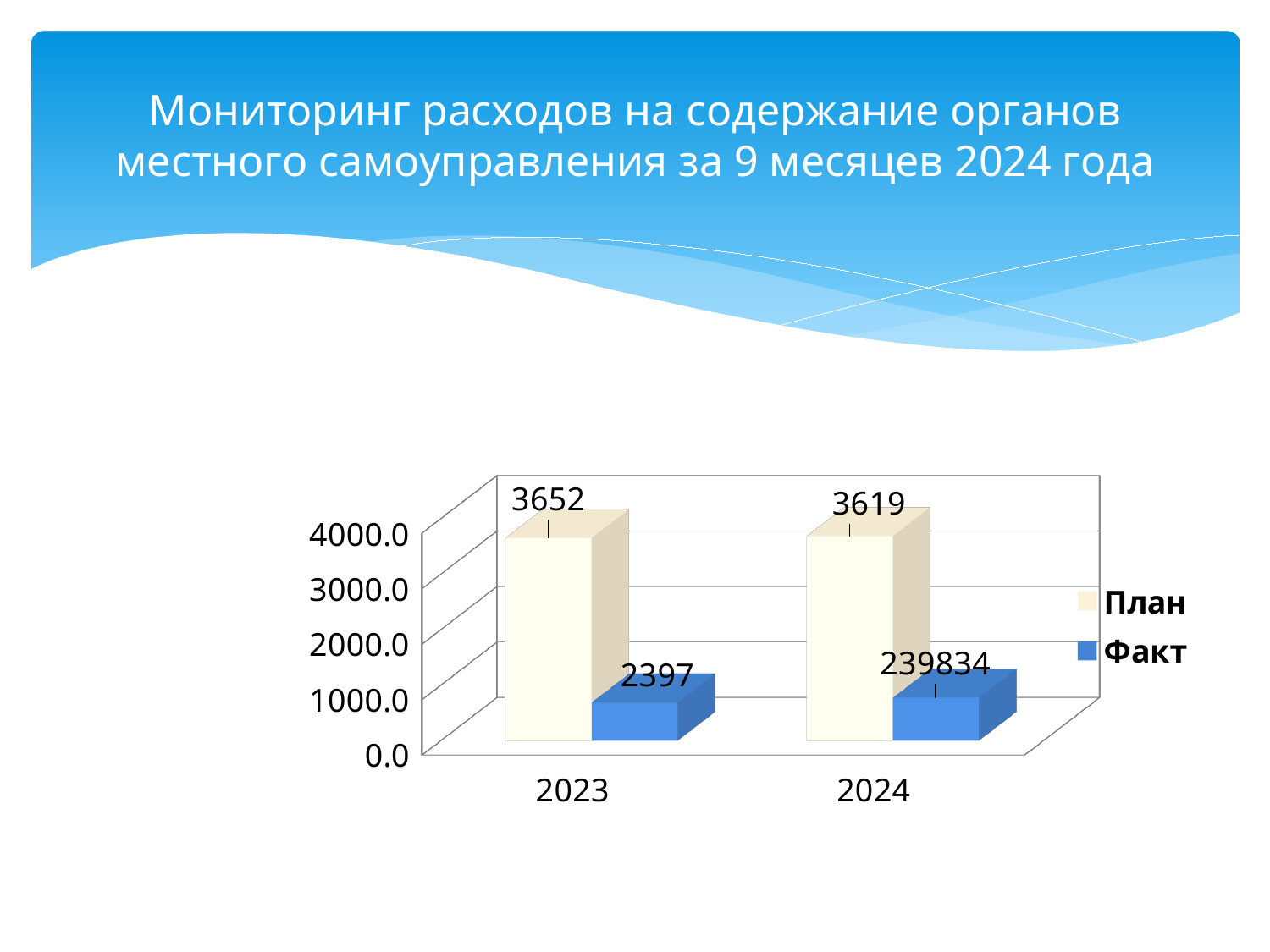
What is the difference between the План values for 2023 and 2024? 33 What kind of chart is shown on the slide? bar chart What is the difference between План and Факт for 2023? 1255 What is the value of План for 2024? 3619 For 2023, which is larger, План or Факт? План How many series does the legend list? 2 What is the value of Факт for 2023? 2397 How many years are shown on the x axis? 2 Is the Факт value for 2023 greater or less than 3000.0? less What is the value of План for 2023? 3652